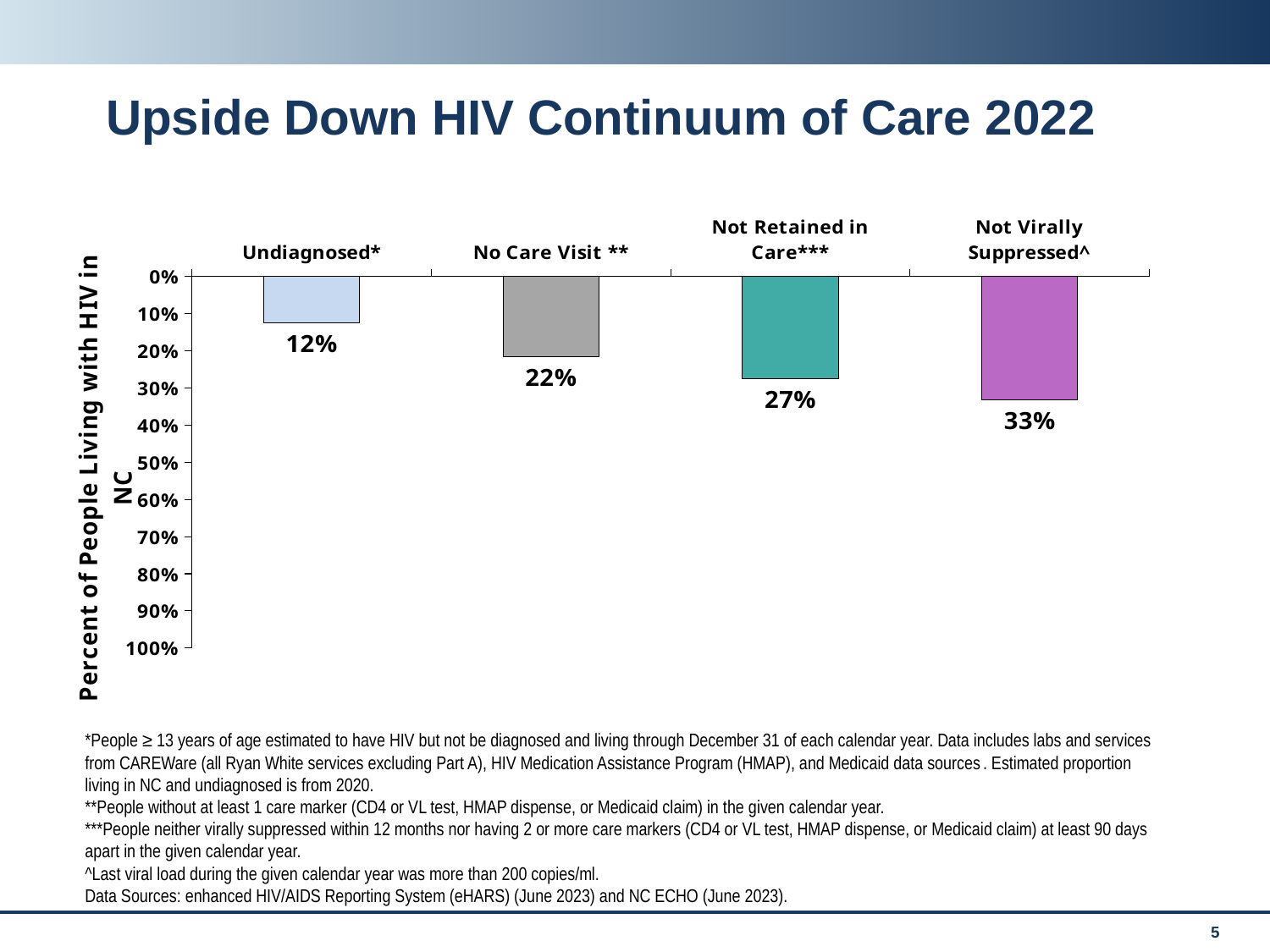
What is the value for Not Virally Suppressed^? 33% What is the difference between the values for Not Retained in Care*** and No Care Visit **? 5% What is the value for Not Retained in Care***? 27% What is the value for No Care Visit **? 22% Which category has the lowest value? Undiagnosed* What kind of chart is shown on the slide? Bar chart What is the difference between the values for Not Virally Suppressed^ and Undiagnosed*? 21% Which is larger, the value for No Care Visit ** or the value for Not Retained in Care***? Not Retained in Care*** How many categories are shown in the chart? 4 Which category has the highest value? Not Virally Suppressed^ What is the value for Undiagnosed*? 12% Do the values rise or fall from left to right across the categories? Rise